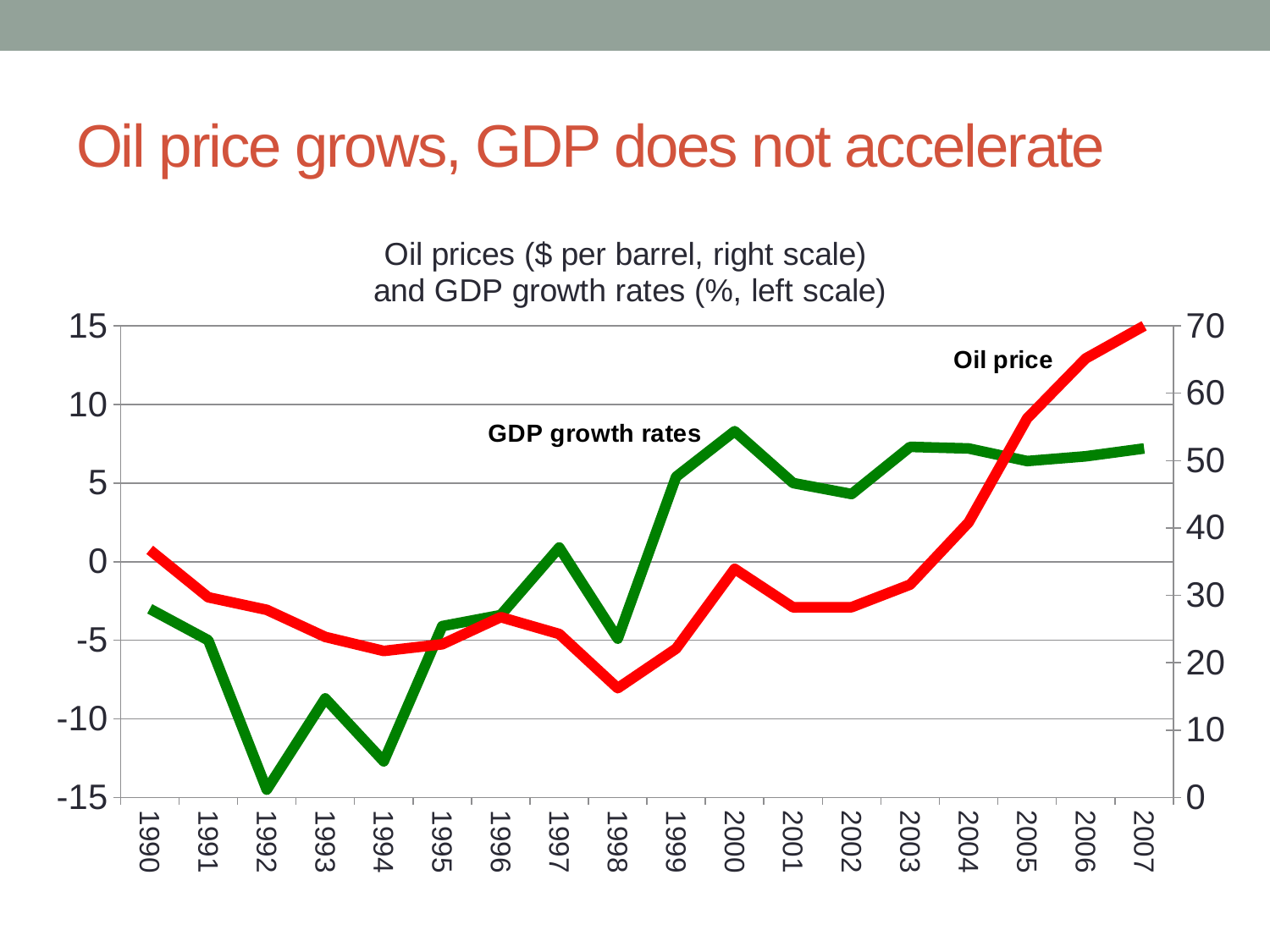
Is the oil price for 2007 greater or less than 60? greater In which year is the GDP growth rate at its lowest? 1992 In which year is the oil price at its lowest? 1998 Does the oil price rise or fall from 2003 to 2007? rise How many years are shown along the x axis of the chart? 18 In which year is the oil price at its highest? 2007 Is the oil price for 1998 greater or less than 20? less In which year is the GDP growth rate at its highest? 2000 What kind of chart is shown on the slide? line chart How many series are plotted on the chart? 2 Which scale is used for the oil price series, the left or the right? right scale Is the GDP growth rate for 1992 greater or less than -10? less